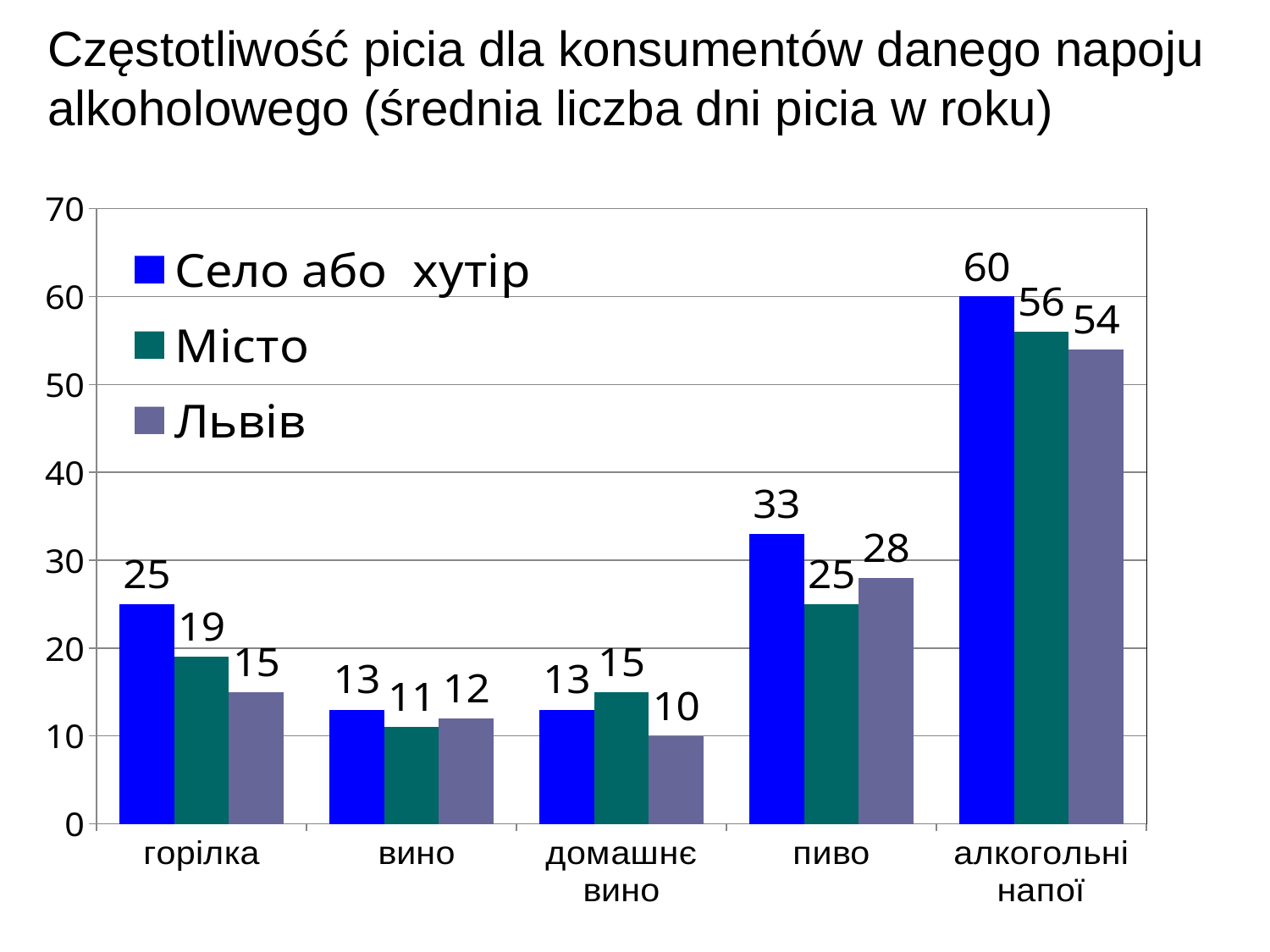
Is the value for Село або хутір for пиво greater or less than 30? greater Which category has the lowest value for Львів? домашнє вино Which category has the highest value for Село або хутір? алкогольні напої Which series is shown in blue? Село або хутір What kind of chart is shown? bar chart What is the value for Львів for пиво? 28 What is the value for Село або хутір for горілка? 25 How many series does the legend list? 3 How many categories are shown on the x axis? 5 What is the difference between Село або хутір and Львів for алкогольні напої? 6 Which is larger for вино: Місто or Львів? Львів What is the value for Місто for домашнє вино? 15